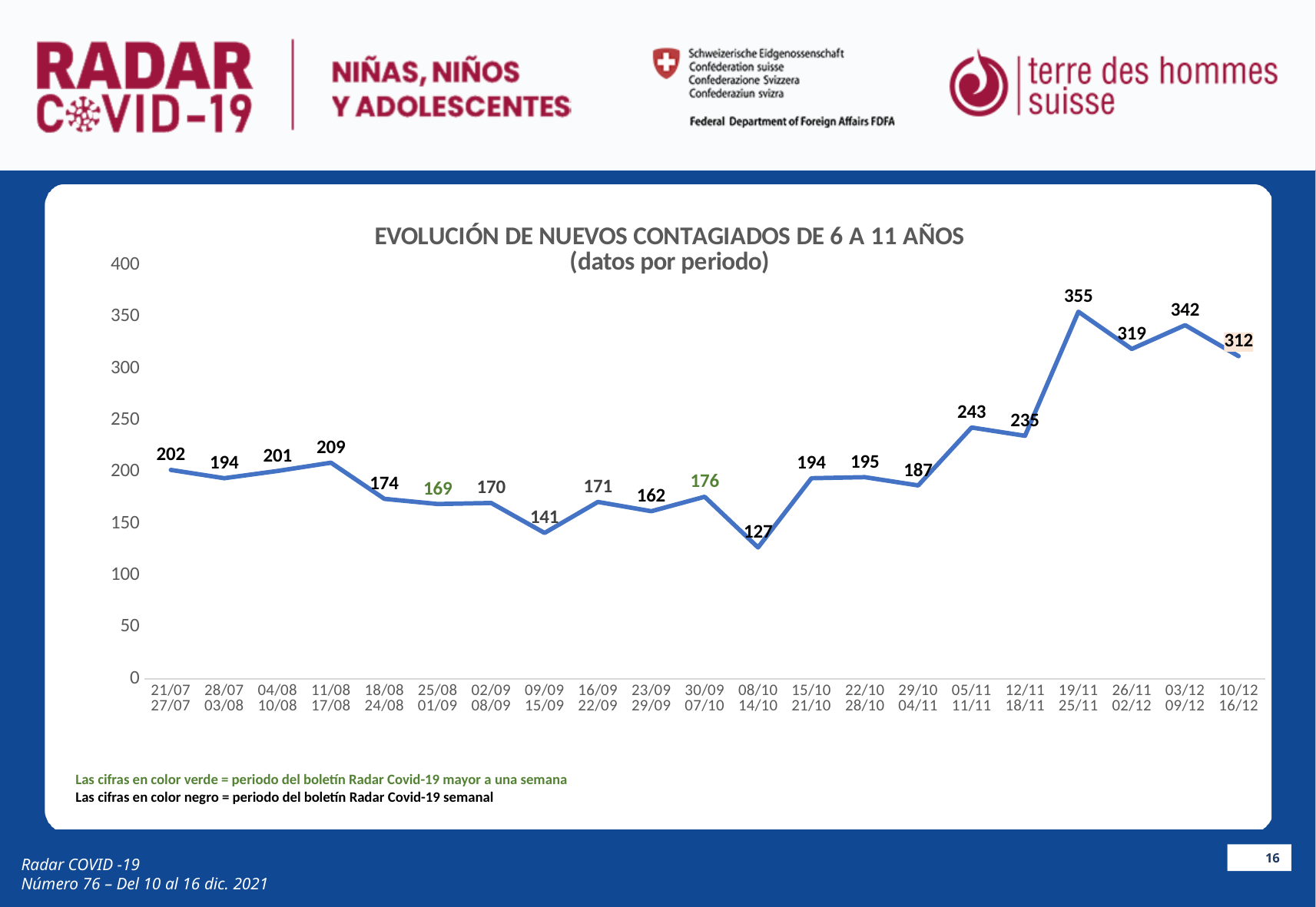
According to the note below the chart, what do the green figures represent? Periodo del boletín Radar Covid-19 mayor a una semana What is the value for the period 08/10–14/10? 127 What kind of chart is shown on the slide? Line chart Which period has the highest value? 19/11–25/11 What is the value for the period 10/12–16/12? 312 How many periods are plotted on the chart? 21 What is the difference between the values for 19/11–25/11 and 10/12–16/12? 43 Do the values rise or fall from 29/10–04/11 to 19/11–25/11? Rise What is the value for the period 21/07–27/07? 202 Which period has the lowest value? 08/10–14/10 Which is larger, the value for 05/11–11/11 or the value for 12/11–18/11? 05/11–11/11 What is the value for the period 19/11–25/11? 355